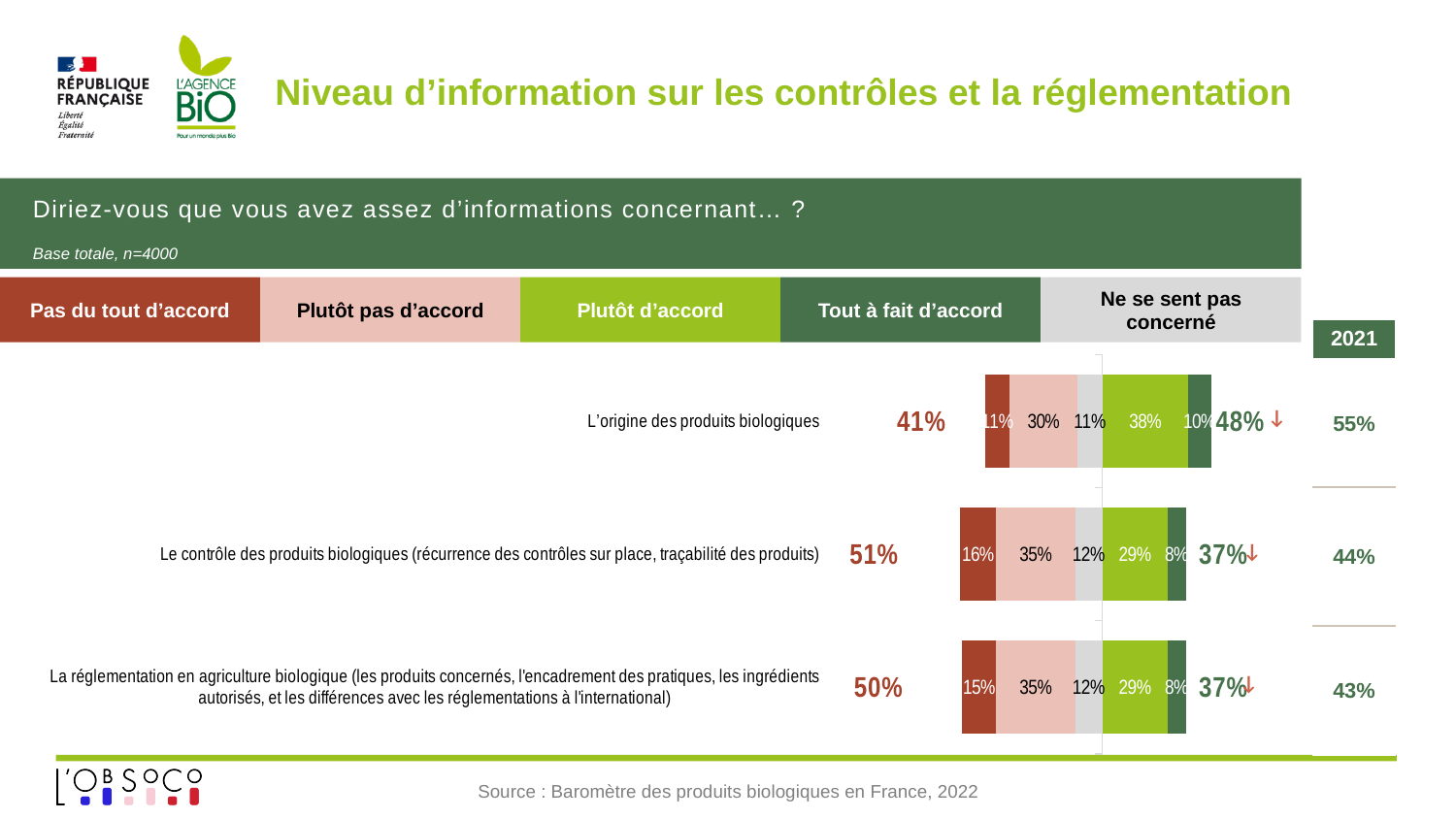
Which is larger: the 'Tout à fait d'accord' value for 'L'origine des produits biologiques' or for 'Le contrôle des produits biologiques'? L'origine des produits biologiques What is the 'Plutôt d'accord' value for 'L'origine des produits biologiques'? 38% Which statement has the highest 'Plutôt d'accord' value? L'origine des produits biologiques What kind of chart is shown on the slide? stacked bar chart How many statements (categories) are plotted in the chart? 3 Which statement has the lowest 'Pas du tout d'accord' value? L'origine des produits biologiques What is the 'Ne se sent pas concerné' value for 'La réglementation en agriculture biologique'? 12% What is the 'Pas du tout d'accord' value for 'Le contrôle des produits biologiques'? 16% What is the 'Tout à fait d'accord' value for 'L'origine des produits biologiques'? 10% What is the 2021 value shown for 'L'origine des produits biologiques'? 55% What is the difference between the 'Plutôt pas d'accord' values for 'Le contrôle des produits biologiques' and 'L'origine des produits biologiques'? 5% How many response categories does the legend list? 5